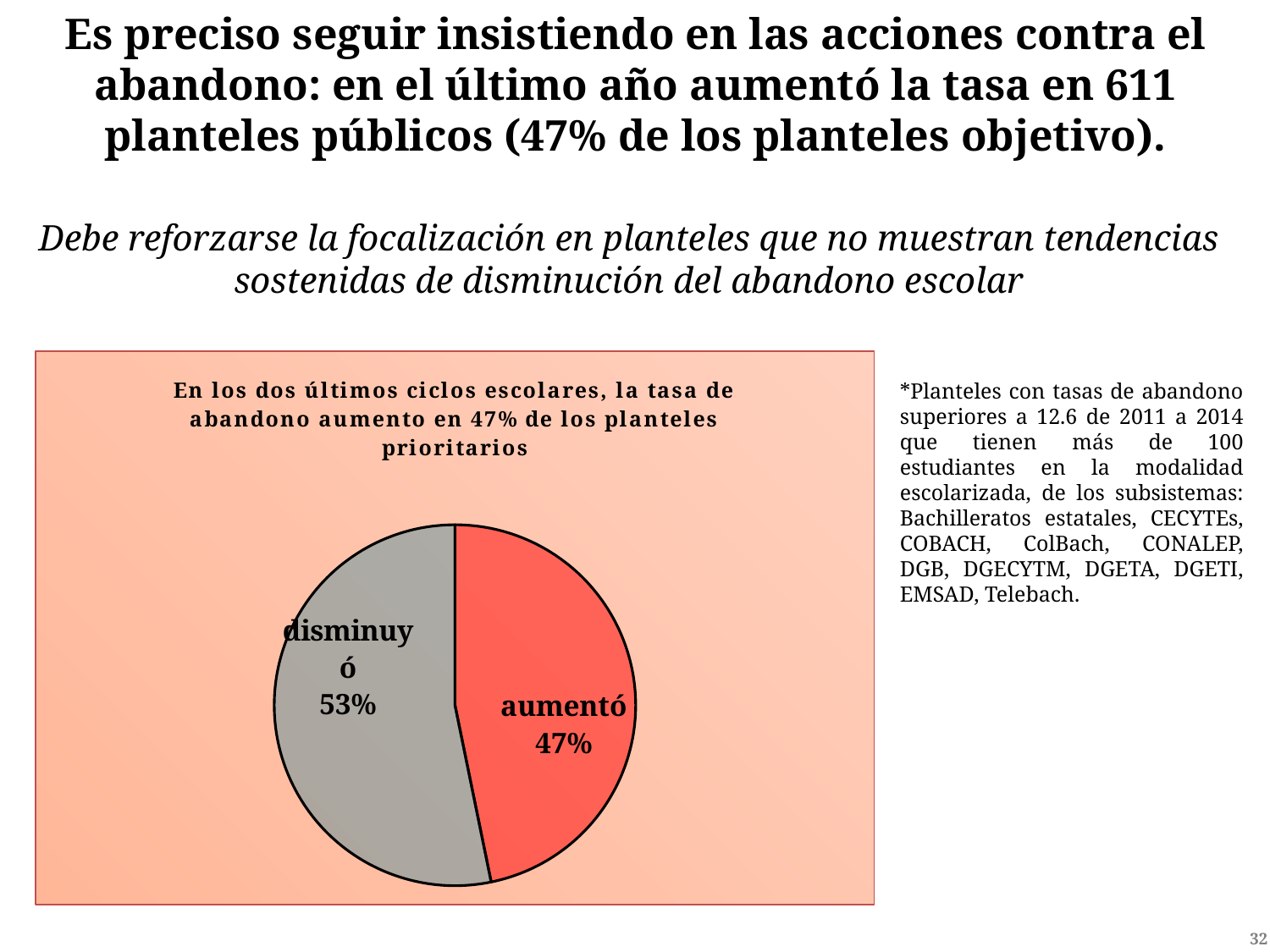
Which is larger, the 'aumentó' slice or the 'disminuyó' slice? disminuyó What share of the pie does the 'disminuyó' slice represent? 53% What colour is the 'aumentó' slice of the pie? red What share of the pie does the 'aumentó' slice represent? 47% Which slice of the pie is the largest? disminuyó Which slice of the pie is the smallest? aumentó What kind of chart is shown on the slide? pie chart What is the title of the pie chart? En los dos últimos ciclos escolares, la tasa de abandono aumento en 47% de los planteles prioritarios What is the total of the two slices shown in the pie chart? 100% What is the difference in percentage points between the 'disminuyó' and 'aumentó' slices? 6 percentage points How many slices does the pie chart have? 2